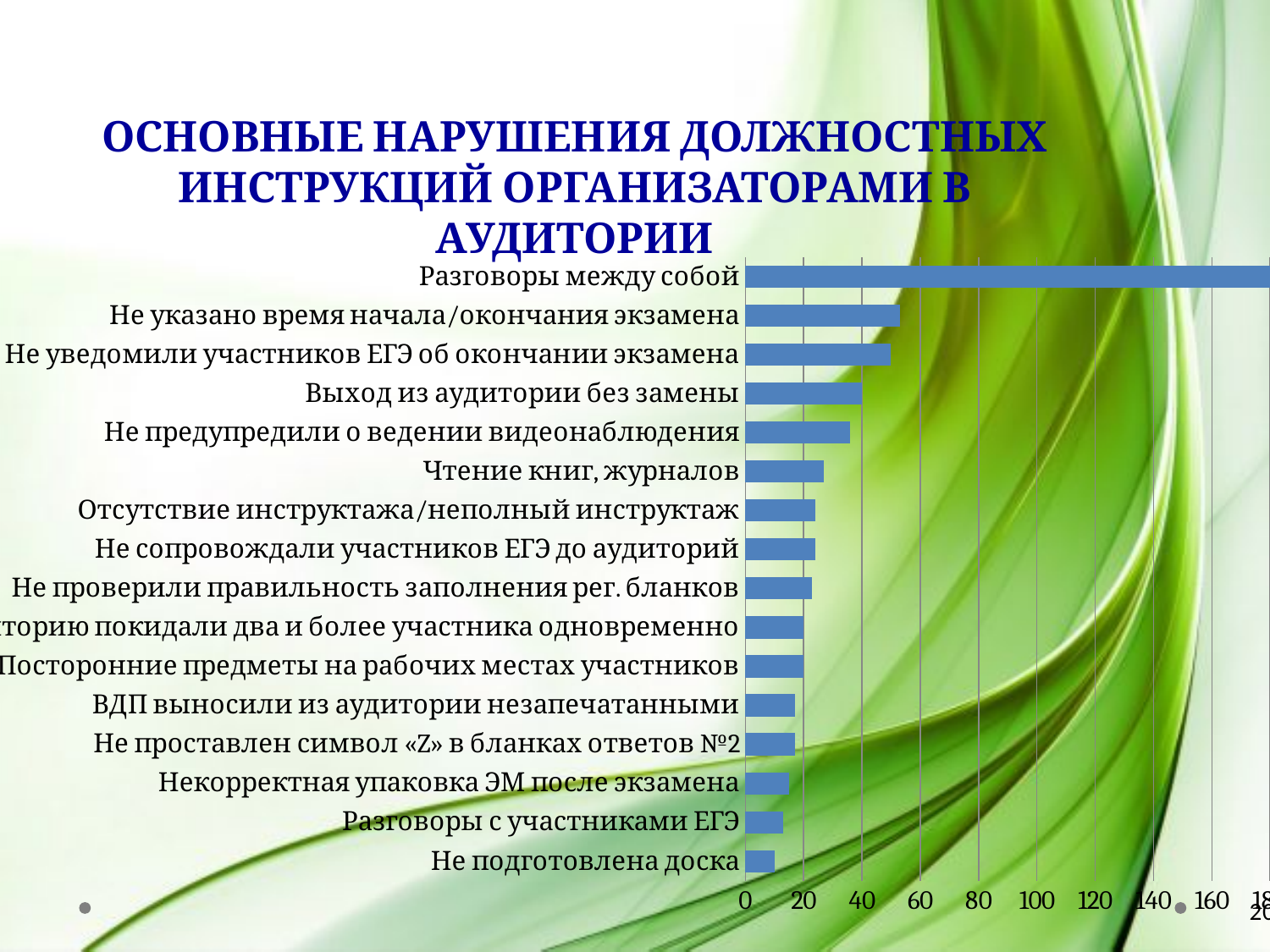
Which category has the lowest value in the chart? Не подготовлена доска Is the value for "Не подготовлена доска" greater or less than 20? less How many categories (violation types) are plotted in the chart? 16 Which is larger: the value for "Не указано время начала/окончания экзамена" or for "Чтение книг, журналов"? Не указано время начала/окончания экзамена Is the value for "Чтение книг, журналов" greater or less than 20? greater Do the bar values increase or decrease going from the top category to the bottom category? decrease Which category has the highest value in the chart? Разговоры между собой Is the value for "Разговоры между собой" greater or less than 160? greater What kind of chart is shown on the slide? bar chart What is the title of the slide containing the chart? ОСНОВНЫЕ НАРУШЕНИЯ ДОЛЖНОСТНЫХ ИНСТРУКЦИЙ ОРГАНИЗАТОРАМИ В АУДИТОРИИ